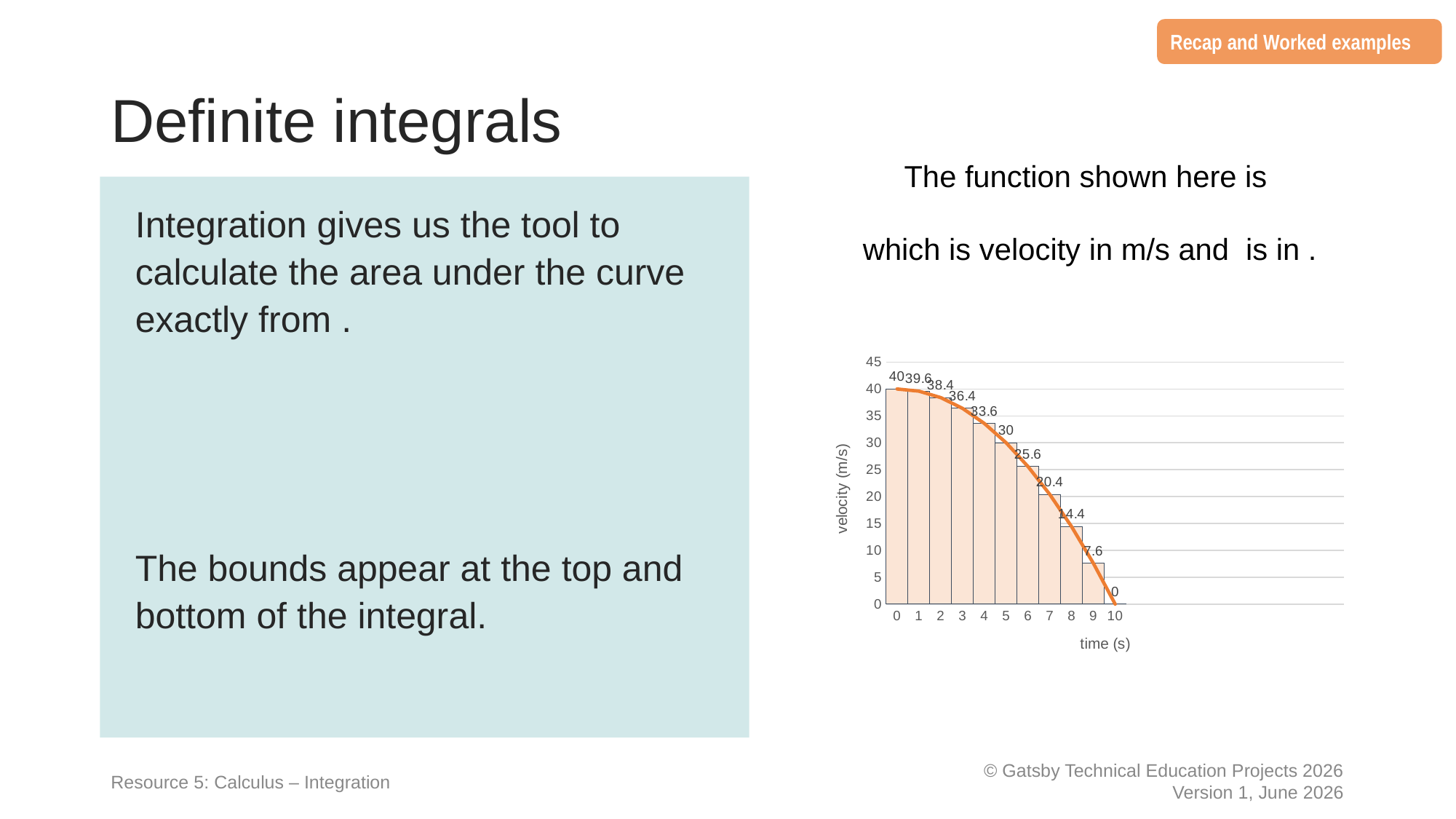
What is the velocity value labelled at time 5 s on the chart? 30 How many time points are labelled on the x axis of the chart? 11 At which time is the labelled velocity highest on the chart? 0 What is the velocity value labelled at time 2 s on the chart? 38.4 Which is larger, the velocity at time 3 s or the velocity at time 9 s? time 3 s Is the velocity at time 7 s greater or less than 25? less What is the difference between the velocity at time 0 s and the velocity at time 10 s? 40 What is the velocity value labelled at time 8 s on the chart? 14.4 What is the label on the vertical axis of the chart? velocity (m/s) At which time is the labelled velocity lowest on the chart? 10 Do the velocity values rise or fall as time increases along the x axis? fall What is the difference between the velocity at time 6 s and the velocity at time 7 s? 5.2